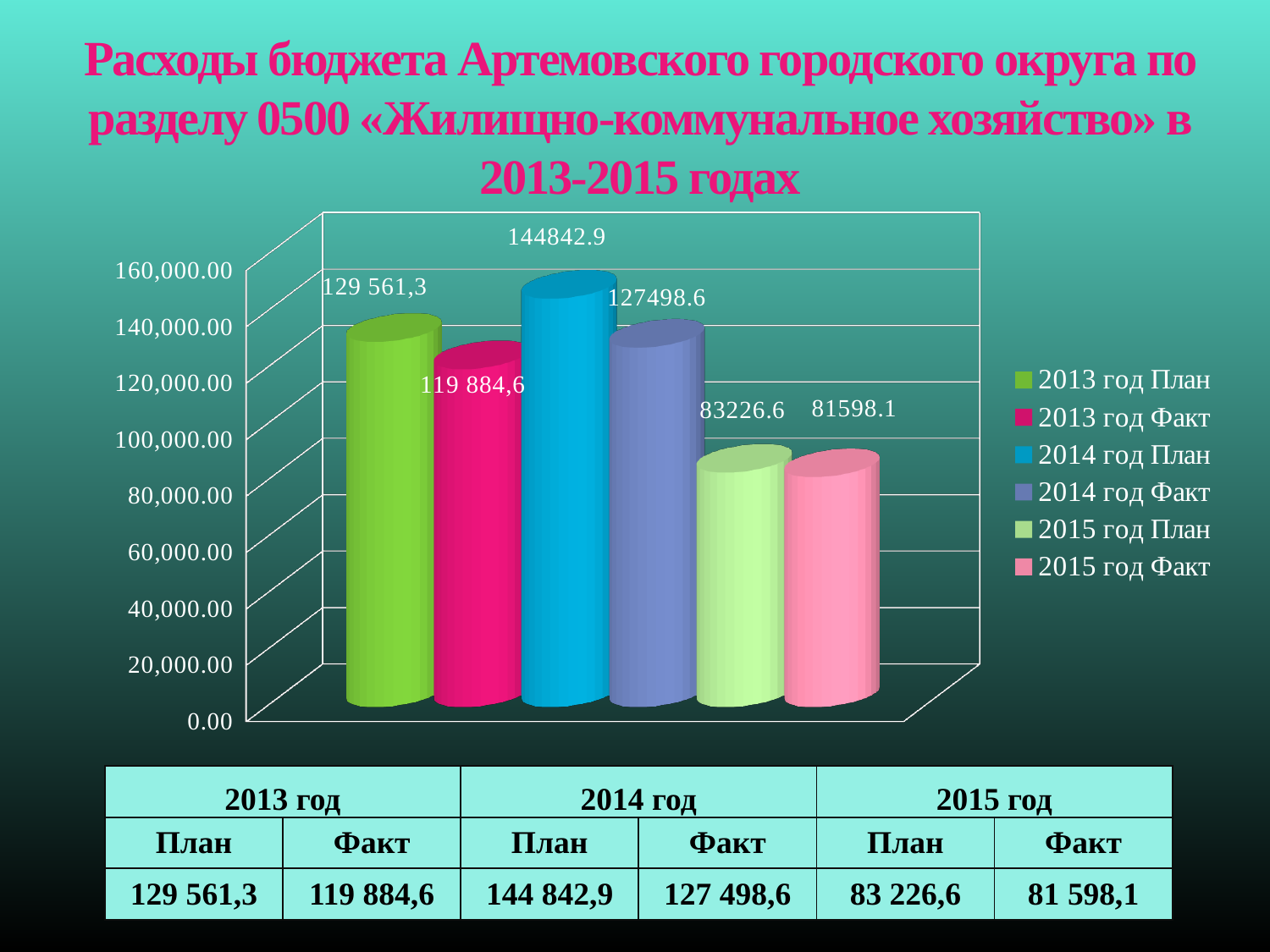
How many series does the legend list? 6 What kind of chart is shown on the slide? bar chart What is the value shown for 2013 год План? 129 561,3 What is the value shown for 2015 год План? 83226.6 Which is larger, the value for 2013 год Факт or the value for 2014 год Факт? 2014 год Факт Which series has the highest value in the chart? 2014 год План Which series has the lowest value in the chart? 2015 год Факт What is the difference between the 2013 год План and 2013 год Факт values? 9676.7 What is the difference between the 2014 год План and 2014 год Факт values? 17344.3 What colour is the bar for 2014 год План? blue What is the value shown for 2014 год Факт? 127498.6 Is the value for 2015 год Факт greater or less than 100,000.00? less